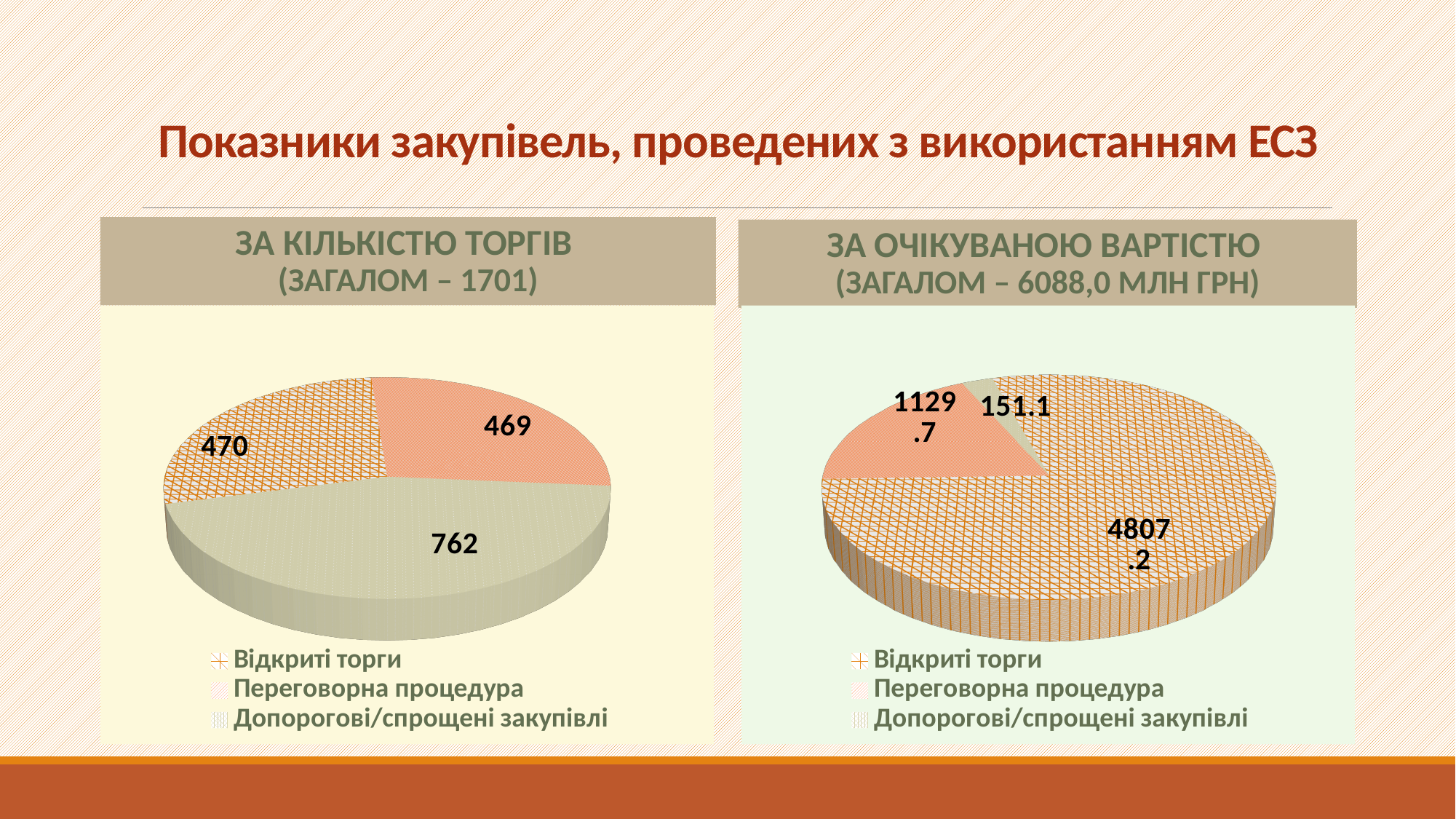
What type of chart is used on the right (ЗА ОЧІКУВАНОЮ ВАРТІСТЮ)? pie chart In the right chart (ЗА ОЧІКУВАНОЮ ВАРТІСТЮ), what is the value for Відкриті торги? 4807.2 In the left chart (ЗА КІЛЬКІСТЮ ТОРГІВ), which category has the largest slice? Допорогові/спрощені закупівлі In the right chart (ЗА ОЧІКУВАНОЮ ВАРТІСТЮ), which category has the smallest slice? Допорогові/спрощені закупівлі In the left chart (ЗА КІЛЬКІСТЮ ТОРГІВ), what is the value for Відкриті торги? 470 How many slices does the left chart (ЗА КІЛЬКІСТЮ ТОРГІВ) have? 3 In the left chart (ЗА КІЛЬКІСТЮ ТОРГІВ), what is the difference between Допорогові/спрощені закупівлі and Відкриті торги? 292 In the left chart (ЗА КІЛЬКІСТЮ ТОРГІВ), what is the value for Допорогові/спрощені закупівлі? 762 In the right chart (ЗА ОЧІКУВАНОЮ ВАРТІСТЮ), which category has the largest slice? Відкриті торги In the right chart (ЗА ОЧІКУВАНОЮ ВАРТІСТЮ), what is the value for Допорогові/спрощені закупівлі? 151.1 In the right chart (ЗА ОЧІКУВАНОЮ ВАРТІСТЮ), is the value for Відкриті торги larger or smaller than the value for Переговорна процедура? larger In the left chart (ЗА КІЛЬКІСТЮ ТОРГІВ), what is the value for Переговорна процедура? 469